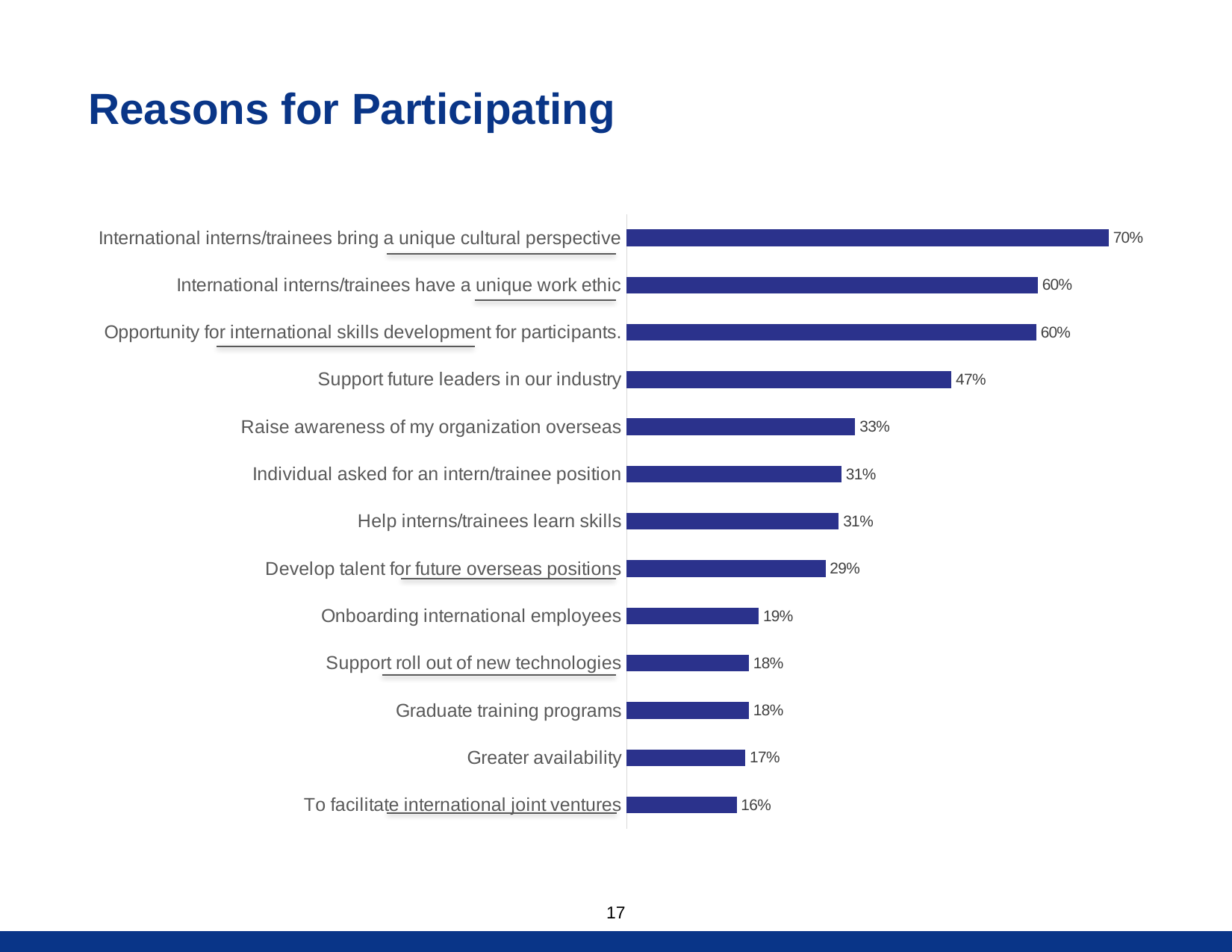
What is the value for "Support future leaders in our industry"? 47% Which reason has the lowest percentage? To facilitate international joint ventures Which is larger: "Raise awareness of my organization overseas" or "Develop talent for future overseas positions"? Raise awareness of my organization overseas What is the difference between "Raise awareness of my organization overseas" and "Greater availability"? 16% What percentage is shown for "International interns/trainees bring a unique cultural perspective"? 70% Which reason has the highest percentage? International interns/trainees bring a unique cultural perspective What is the value for "To facilitate international joint ventures"? 16% What kind of chart is shown on the slide? Bar chart What percentage is shown for "Onboarding international employees"? 19% How many reasons are listed in the chart? 13 What is the difference between "International interns/trainees bring a unique cultural perspective" and "Support future leaders in our industry"? 23% What is the title of the slide? Reasons for Participating